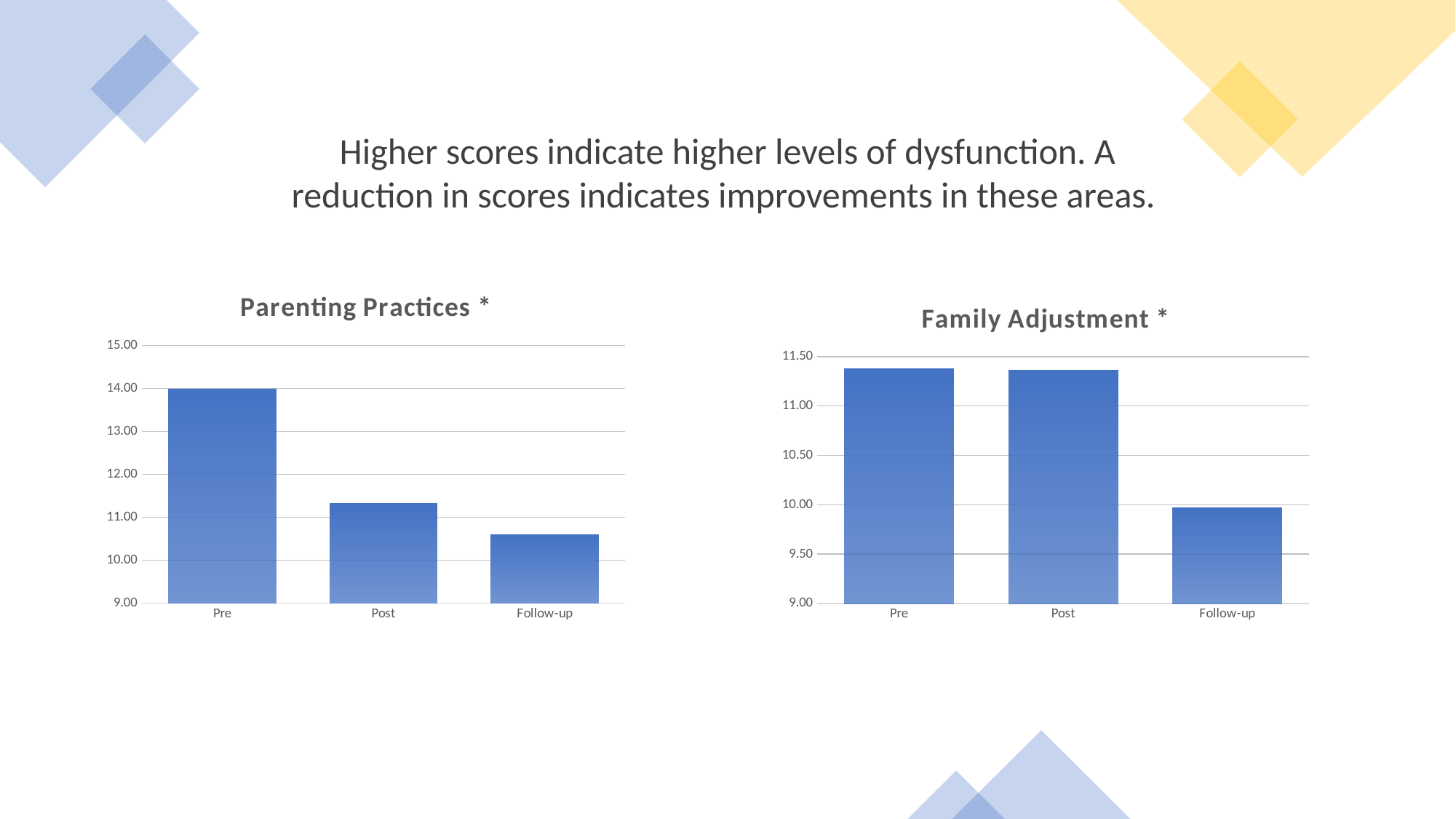
In the Family Adjustment * chart, which category has the lowest value? Follow-up In the Parenting Practices * chart, which category has the lowest value? Follow-up In the Parenting Practices * chart, do the values rise or fall from Pre to Follow-up? fall In the Parenting Practices * chart, is the value for Follow-up greater or less than 10.00? greater What is the title of the chart on the right side of the slide? Family Adjustment * In the Family Adjustment * chart, is the value for Follow-up greater or less than 10.50? less What kind of chart is the Parenting Practices * chart? bar chart In the Family Adjustment * chart, which is larger, the value for Pre or the value for Follow-up? Pre In the Parenting Practices * chart, which category has the highest value? Pre In the Parenting Practices * chart, is the value for Post greater or less than 12.00? less How many categories are shown on the x axis of the Family Adjustment * chart? 3